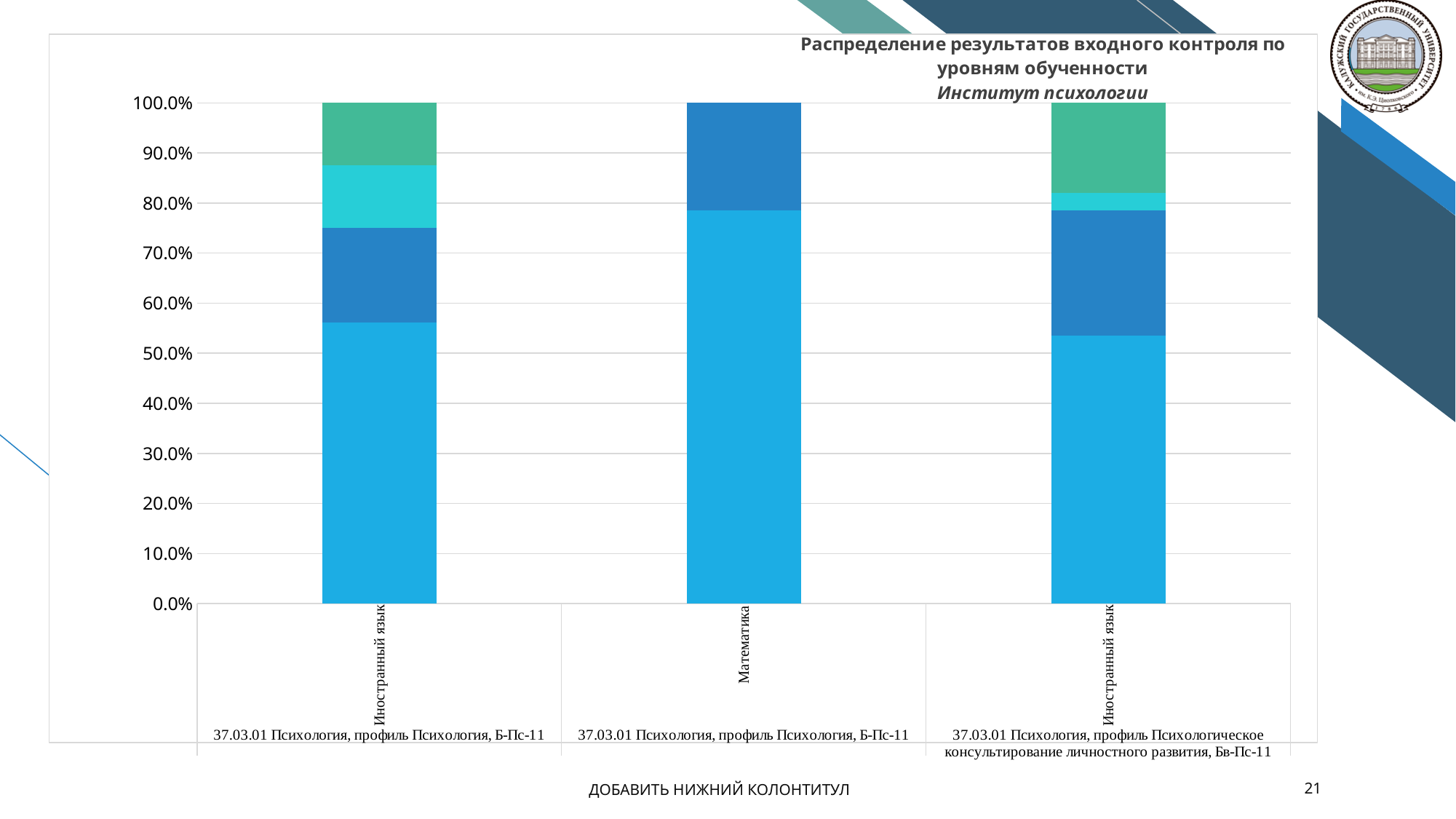
Which has a larger bottom (light blue) segment: the Математика bar or the first Иностранный язык bar (Б-Пс-11)? Математика Is the bottom (light blue) segment of the first Иностранный язык bar (Б-Пс-11) greater or less than 60.0%? less How many stacked segments does the Математика bar contain? 2 What is the total height of the stacked bar for Математика? 100.0% Which institute is named in the chart's subtitle? Институт психологии Is the bottom (light blue) segment of the Математика bar greater or less than 70.0%? greater Which bar has the largest bottom (light blue) segment? Математика What is the title of the chart? Распределение результатов входного контроля по уровням обученности Is the bottom (light blue) segment of the Иностранный язык bar for Бв-Пс-11 greater or less than 60.0%? less What kind of chart is shown on the slide? Stacked bar chart What is the highest value shown on the vertical axis? 100.0% How many bars (categories) are plotted in the chart? 3